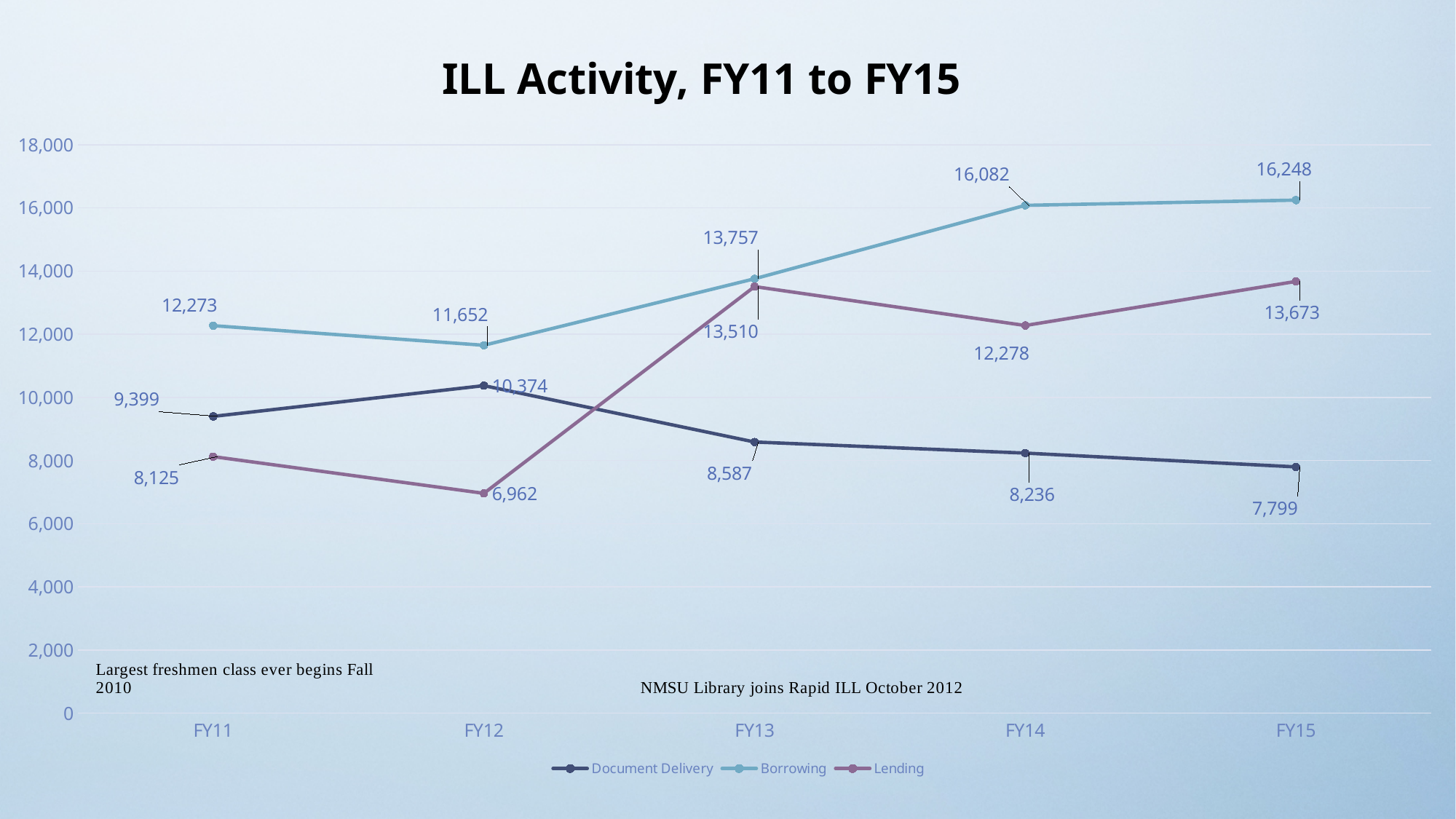
What is the Document Delivery value for FY15? 7,799 Does Document Delivery rise or fall from FY12 to FY15? fall In FY13, which is larger: Lending or Document Delivery? Lending In which fiscal year is Borrowing highest? FY15 How many series does the legend list? 3 What is the Lending value for FY12? 6,962 What is the Borrowing value for FY14? 16,082 How many fiscal years are plotted along the x axis? 5 What is the title of the chart? ILL Activity, FY11 to FY15 What is the difference between the Borrowing values for FY15 and FY14? 166 What kind of chart is shown on the slide? line chart In which fiscal year is Lending lowest? FY12